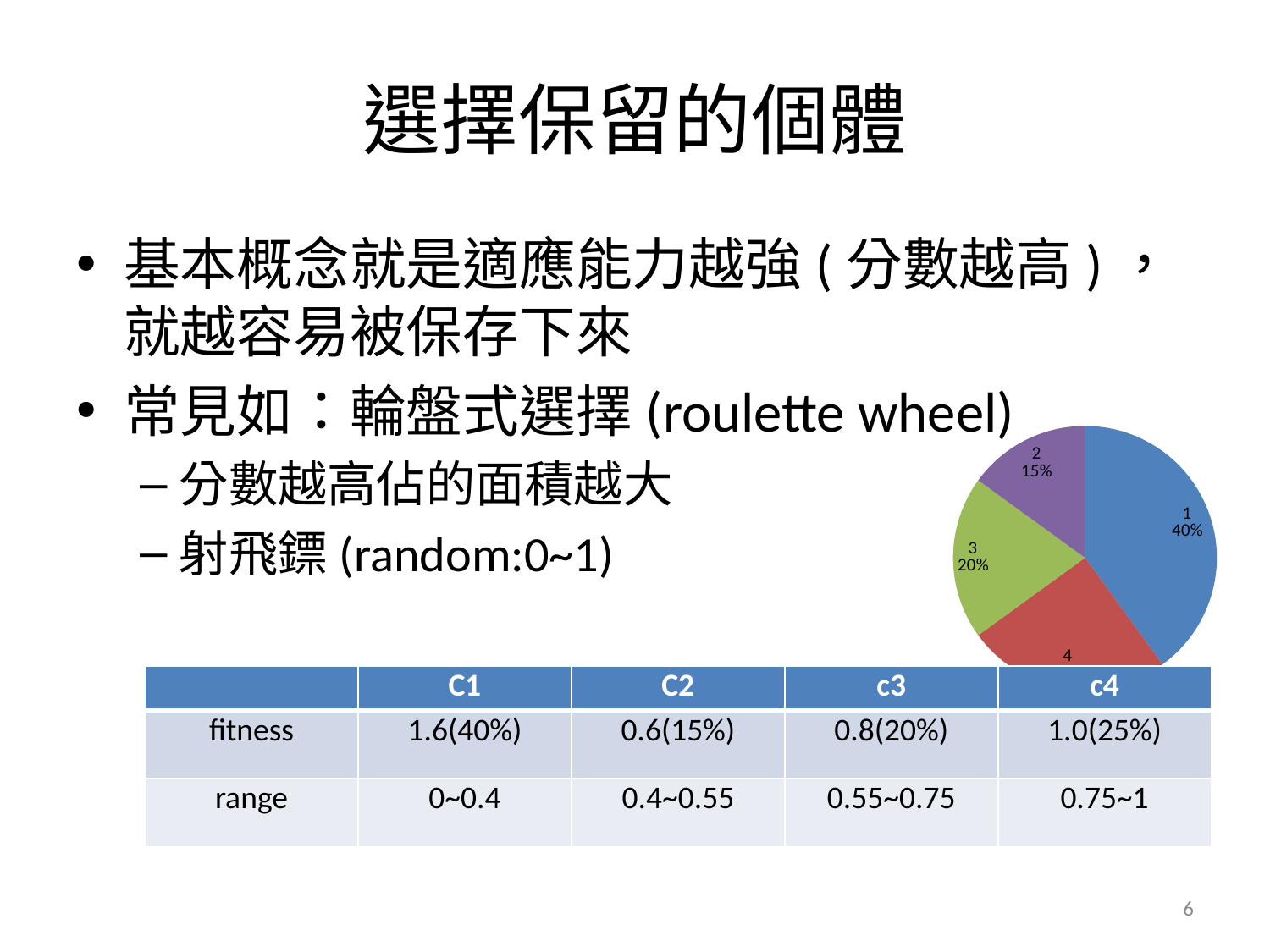
What kind of chart is shown on the slide? pie chart Which slice of the pie chart is the largest? 1 What percentage does slice 1 of the pie chart represent? 40% What is the difference in percentage points between slice 3 and slice 2 of the pie chart? 5 What percentage does slice 3 of the pie chart represent? 20% Which is larger in the pie chart, slice 3 or slice 2? slice 3 Which is larger in the pie chart, slice 1 or slice 4? slice 1 What is the difference in percentage points between slice 1 and slice 2 of the pie chart? 25 Which slice of the pie chart is the smallest? 2 How many slices does the pie chart have? 4 What percentage does slice 2 of the pie chart represent? 15% What colour is slice 1 in the pie chart? blue